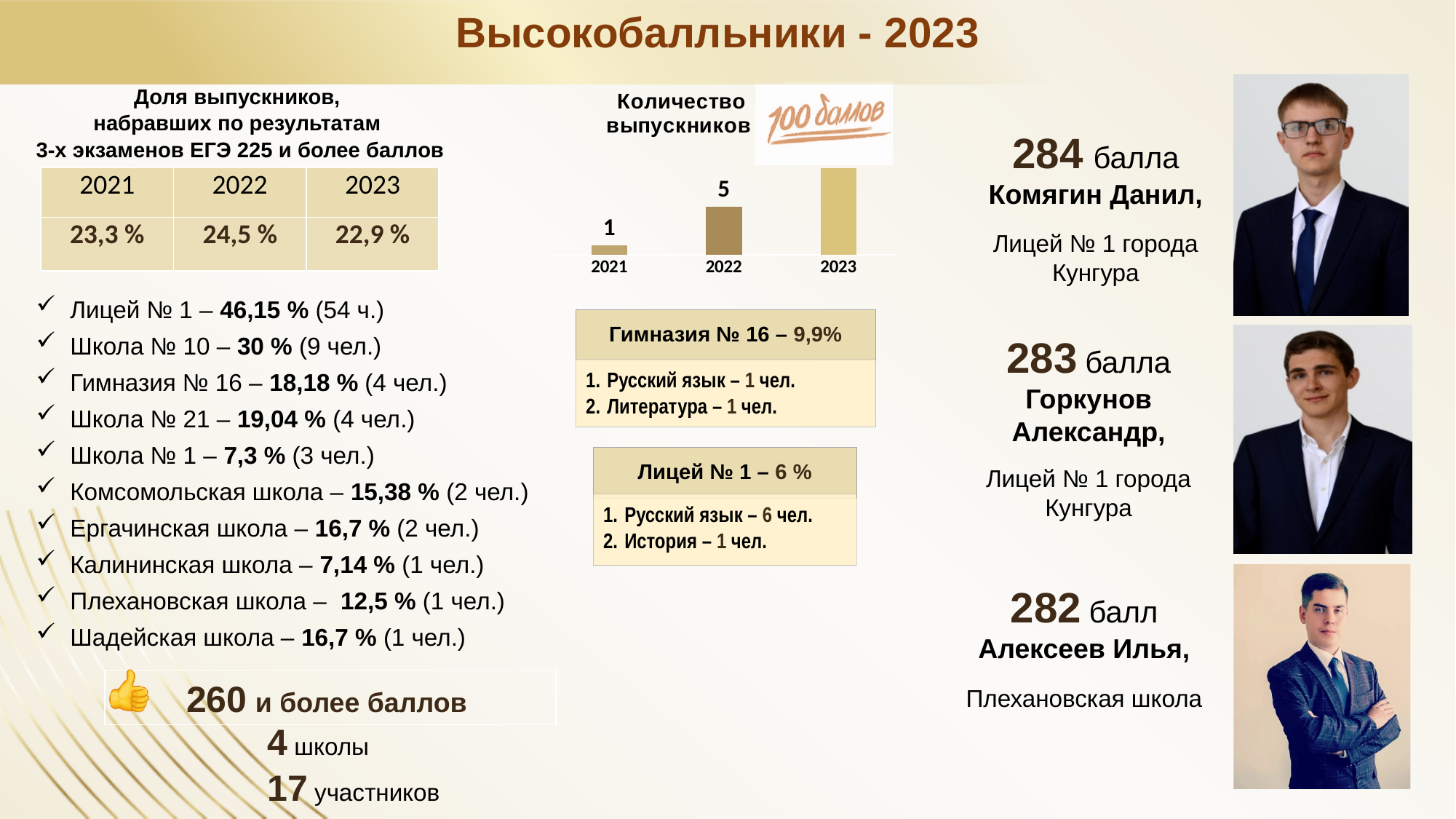
In the bar chart, what is the value for 2021? 1 Which year has the tallest bar in the bar chart? 2023 What kind of chart is shown under the heading "Количество выпускников"? bar chart In the bar chart, which is larger: the value for 2023 or the value for 2022? 2023 In the bar chart, what is the difference between the values for 2022 and 2021? 4 What is the heading written above the bar chart? Количество выпускников Do the values in the bar chart rise or fall from 2021 to 2023? rise Which year has the shortest bar in the bar chart? 2021 In the bar chart, which is larger: the value for 2022 or the value for 2021? 2022 How many years are shown on the x axis of the bar chart? 3 In the bar chart, what is the value for 2022? 5